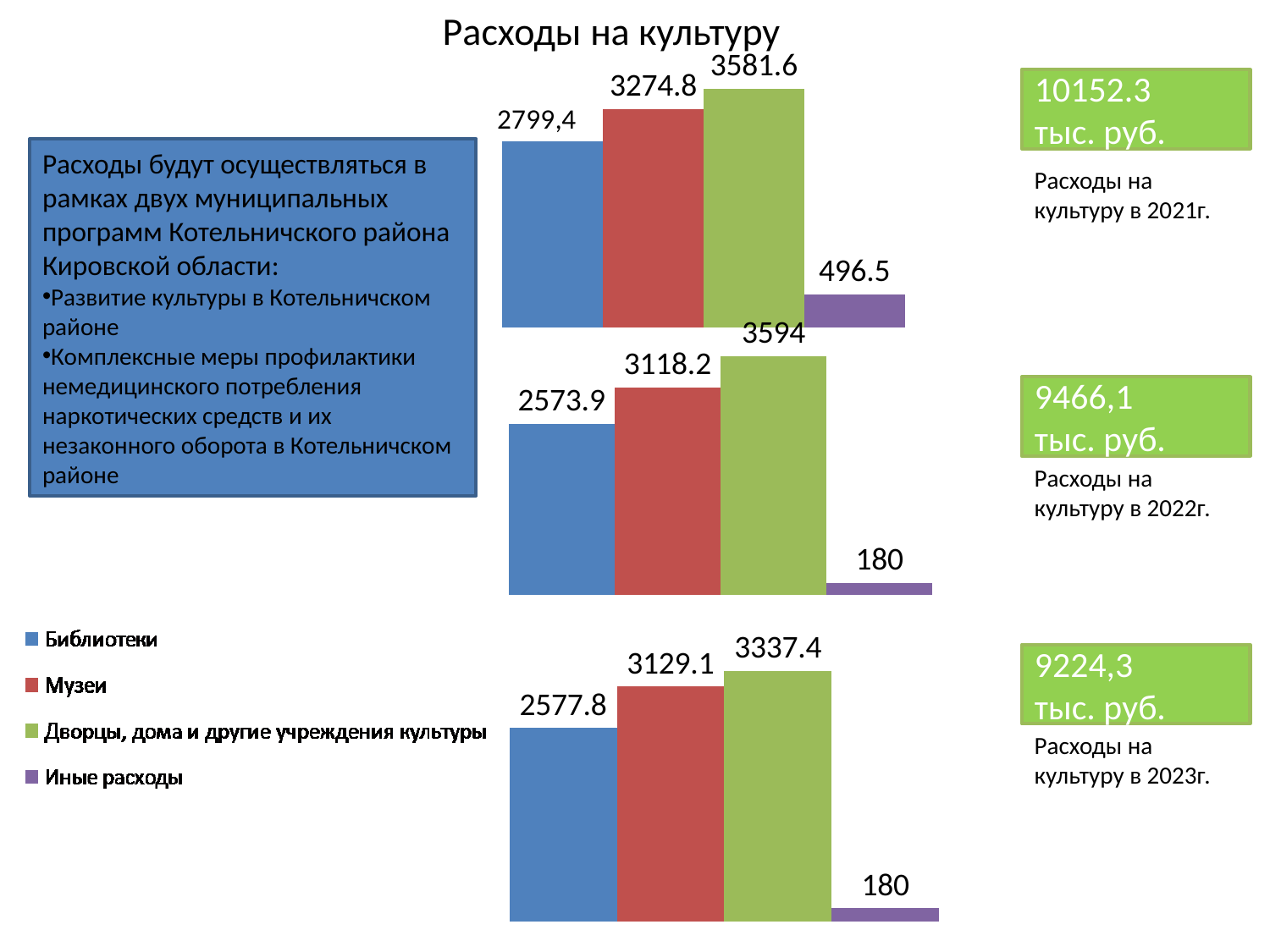
Which colour represents Иные расходы in the legend? Purple In the bottom chart (2023 expenses), what is the value for Библиотеки? 2577.8 In the bottom chart (2023 expenses), what is the difference between the values for Дворцы, дома и другие учреждения культуры and Музеи? 208.3 How many bars are plotted in the bottom chart (2023 expenses)? 4 What kind of chart is the top chart (2021 expenses)? Bar chart In the top chart (2021 expenses), what is the value for Музеи? 3274.8 How many series does the legend list? 4 In the middle chart (2022 expenses), which is larger: the value for Библиотеки or the value for Музеи? Музеи In the top chart (2021 expenses), what is the difference between the values for Музеи and Библиотеки? 475.4 In the top chart (2021 expenses), which category has the highest value? Дворцы, дома и другие учреждения культуры In the middle chart (2022 expenses), what is the value for Дворцы, дома и другие учреждения культуры? 3594 In the middle chart (2022 expenses), which category has the lowest value? Иные расходы